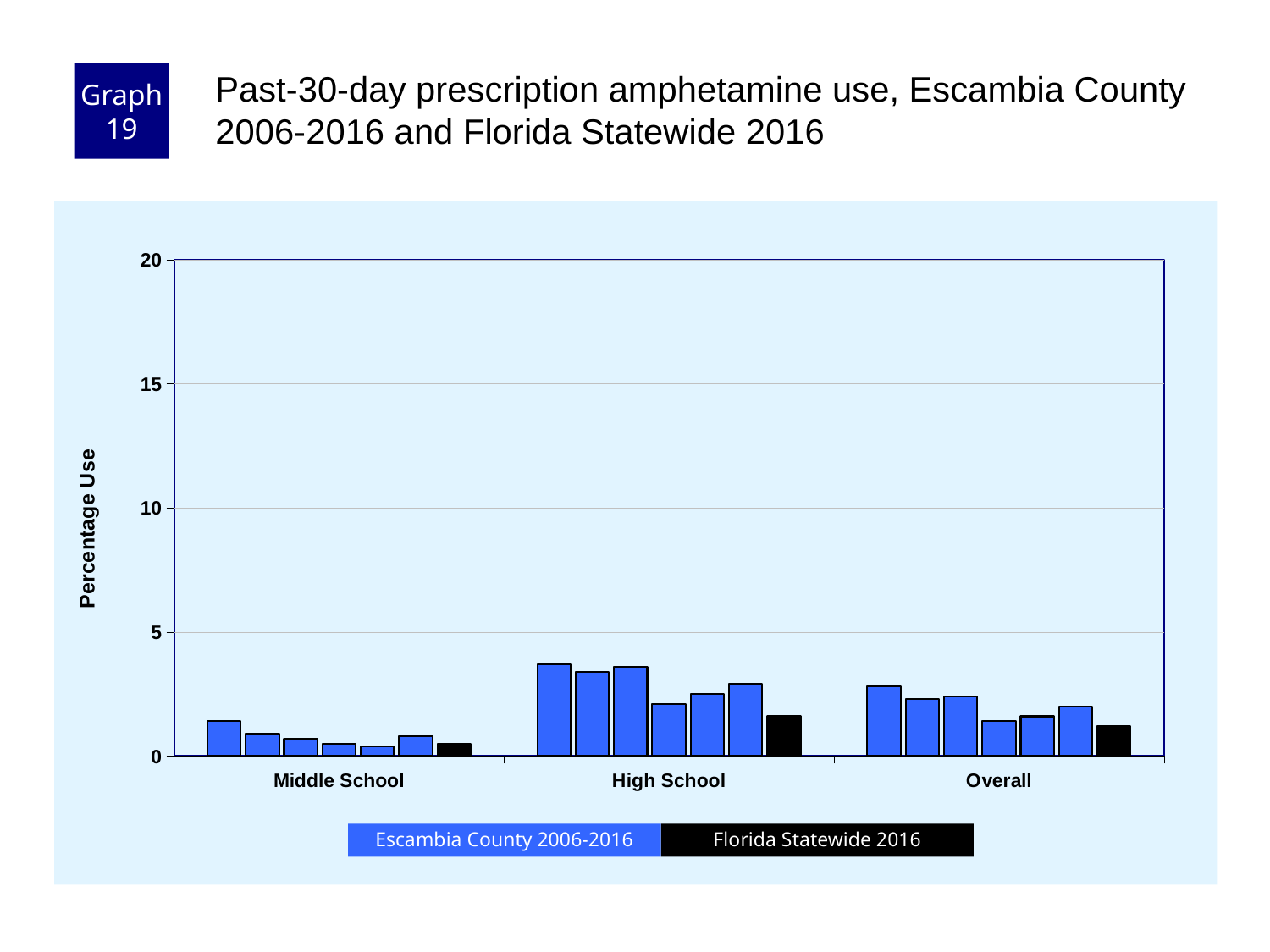
Which group has the lowest bars overall: Middle School, High School, or Overall? Middle School How many series does the legend list? 2 What kind of chart is shown on the slide? bar chart Is the Florida Statewide 2016 value for Middle School greater or less than 5? less How many school-level categories are shown on the x axis? 3 Which is larger, the Florida Statewide 2016 value for High School or the Florida Statewide 2016 value for Middle School? High School Which group has the highest bars overall: Middle School, High School, or Overall? High School Which is larger, the first Escambia County bar in the High School group or the first Escambia County bar in the Middle School group? High School Is the tallest Escambia County bar in the High School group greater or less than 5? less What is the label on the y axis? Percentage Use Is the value for Florida Statewide 2016 in the High School group greater or less than 5? less What colour represents Florida Statewide 2016 in the legend? black